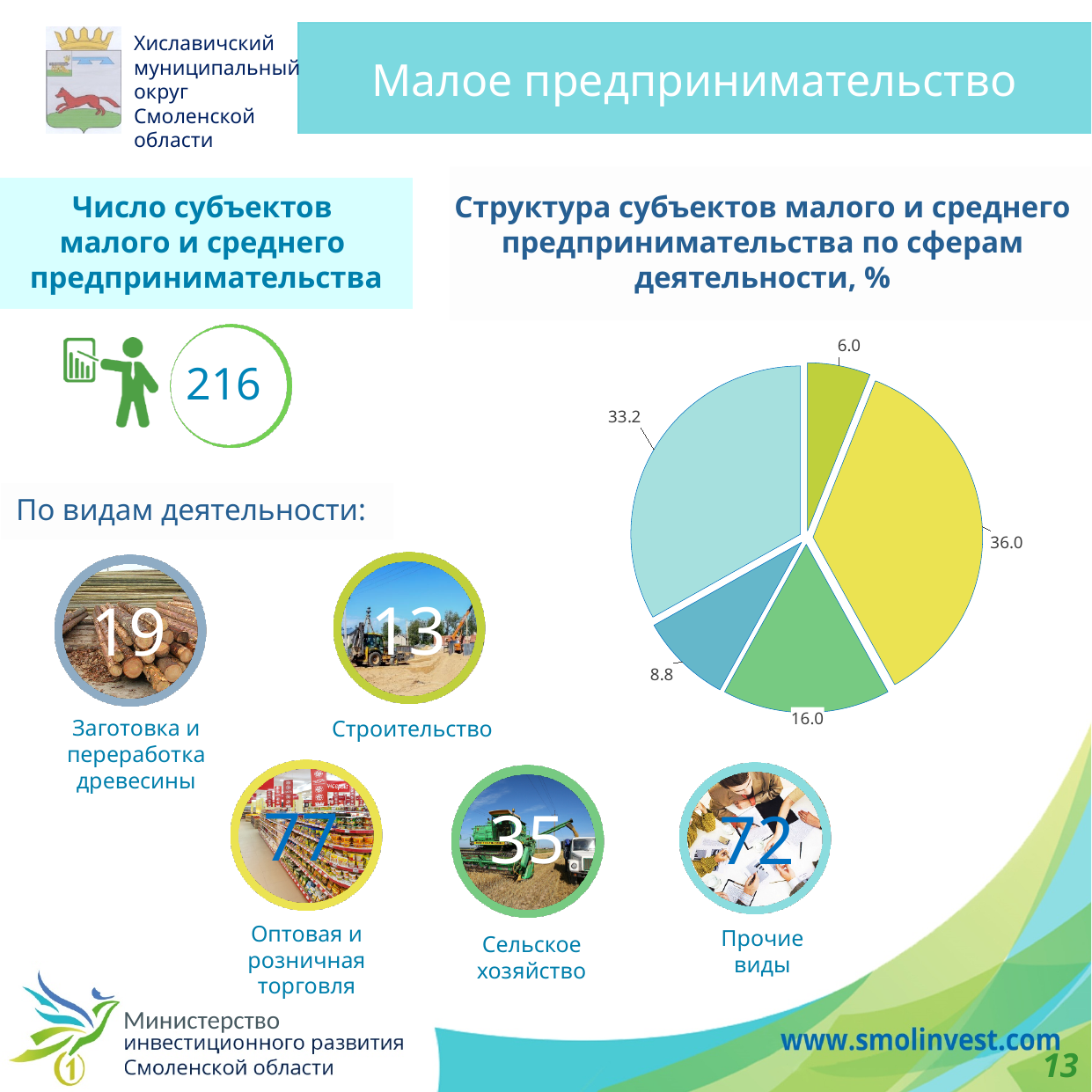
What value is labelled on the yellow slice of the pie chart? 36.0 What is the title of the pie chart? Структура субъектов малого и среднего предпринимательства по сферам деятельности, % In the pie chart, what is the difference between the 16.0 slice and the 8.8 slice? 7.2 What is the value of the largest slice in the pie chart? 36.0 What value is labelled on the green slice of the pie chart? 16.0 What kind of chart is shown under the title "Структура субъектов малого и среднего предпринимательства по сферам деятельности, %"? pie chart In the pie chart, what is the difference between the 36.0 slice and the 33.2 slice? 2.8 What do the five labelled values in the pie chart add up to? 100.0 What is the value of the smallest slice in the pie chart? 6.0 In the pie chart, which is larger: the yellow slice or the light blue slice? the yellow slice (36.0) What value is labelled on the light blue slice of the pie chart? 33.2 How many slices does the pie chart have? 5